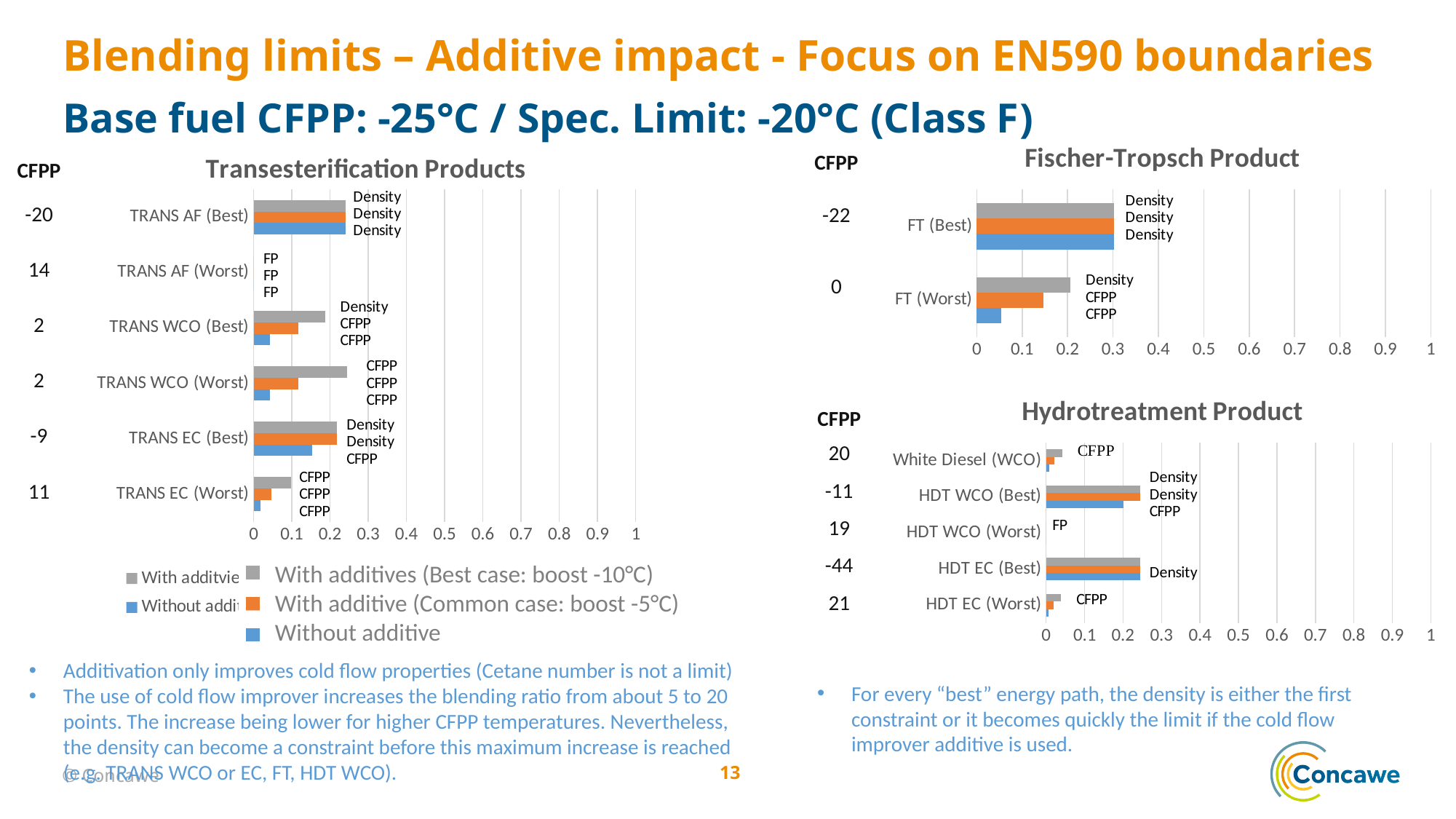
What kind of chart is the Transesterification Products chart? bar chart How many series does the legend of the Transesterification Products chart list? 3 In the Transesterification Products chart, which has the larger 'Without additive' value: TRANS EC (Best) or TRANS WCO (Best)? TRANS EC (Best) In the Hydrotreatment Product chart, is the 'Without additive' value for HDT WCO (Best) greater or less than 0.1? greater How many categories are shown in the Hydrotreatment Product chart? 5 How many categories are shown in the Transesterification Products chart? 6 In the Transesterification Products chart, is the 'With additives (Best case: boost -10°C)' value for TRANS AF (Best) greater or less than 0.2? greater What CFPP value is listed next to HDT EC (Best) in the Hydrotreatment Product chart? -44 In the Fischer-Tropsch Product chart, for FT (Worst), which is larger: the 'With additives (Best case: boost -10°C)' value or the 'Without additive' value? With additives (Best case: boost -10°C) In the Fischer-Tropsch Product chart, is the 'Without additive' value for FT (Best) greater or less than 0.2? greater How many categories are shown in the Fischer-Tropsch Product chart? 2